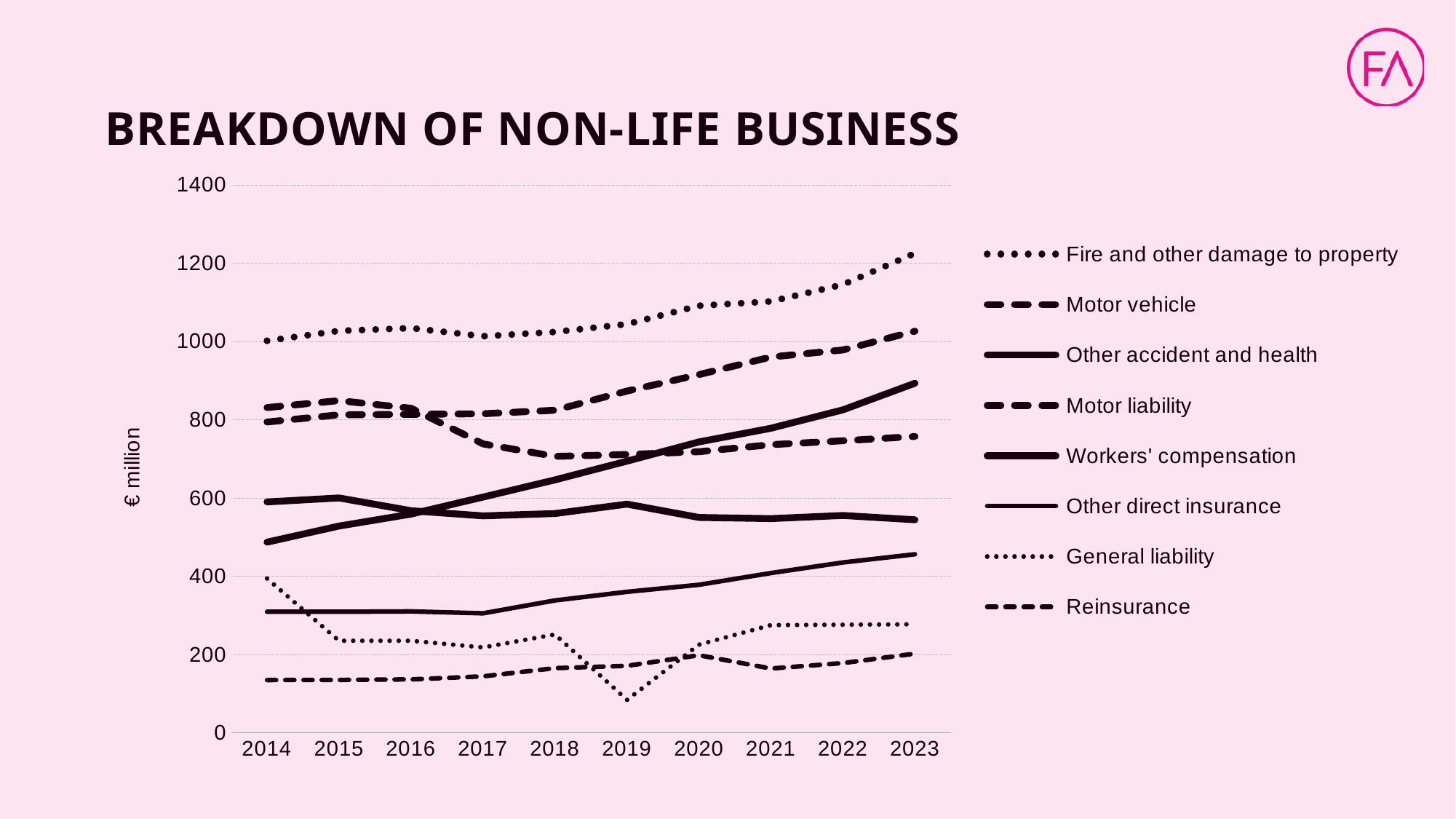
Which series has the highest value in 2023? Fire and other damage to property Is the value for Reinsurance in 2014 greater or less than 200? less What kind of chart is shown on the slide? line chart Which series has the lowest value in 2019? General liability Does the Other accident and health series rise or fall from 2014 to 2023? rise What is the label on the y axis? € million How many years are shown on the x axis? 10 In 2023, which is larger: Motor vehicle or Motor liability? Motor vehicle Which series has the lowest value in 2023? Reinsurance Is the value for Other accident and health in 2014 greater or less than 600? less Is the value for Fire and other damage to property in 2023 greater or less than 1100? greater How many series does the legend list? 8